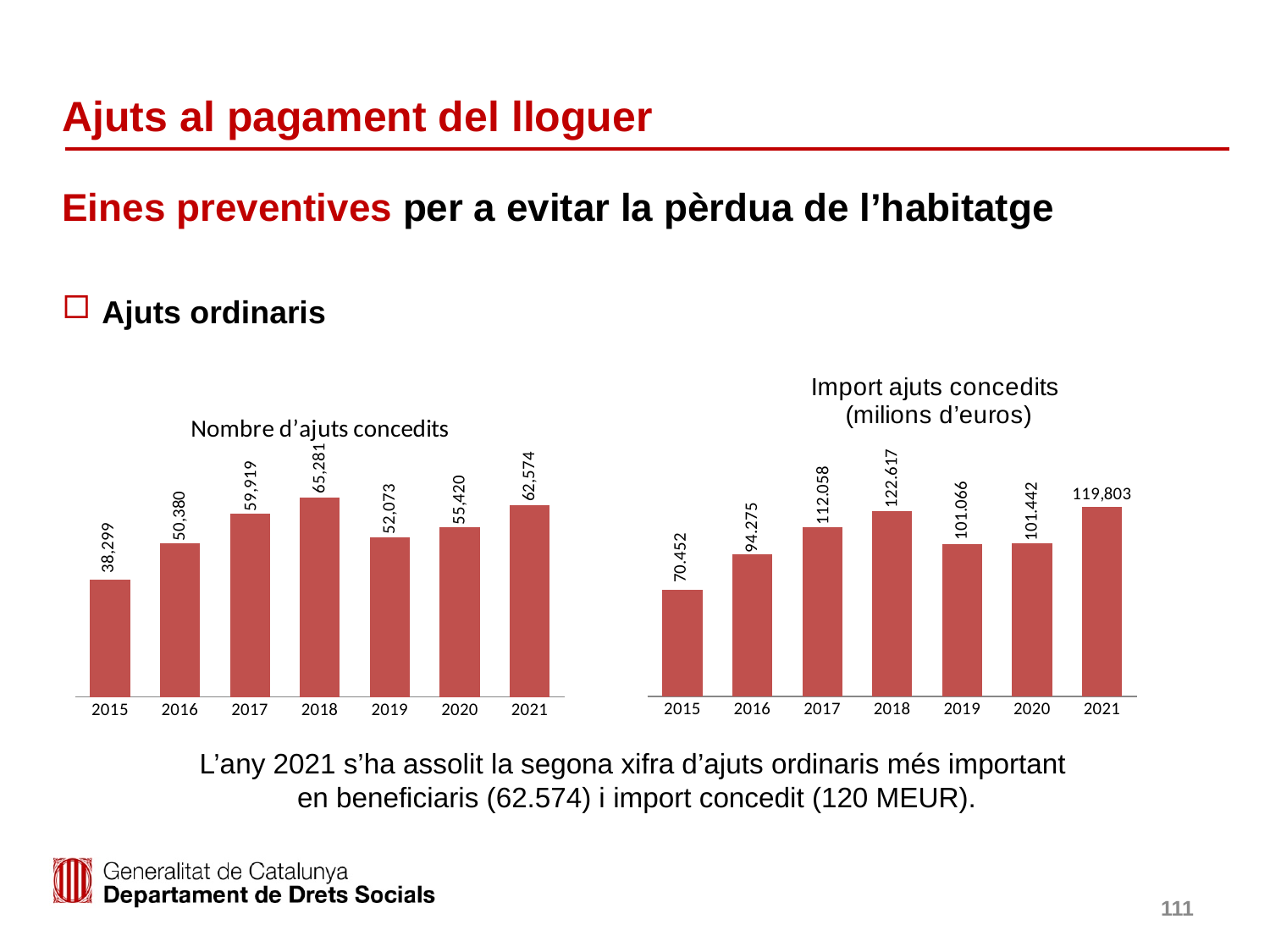
In the chart titled "Nombre d'ajuts concedits", which year has the lowest value? 2015 In the chart titled "Import ajuts concedits (milions d'euros)", which year has the lowest value? 2015 In the chart titled "Nombre d'ajuts concedits", what is the value for 2015? 38,299 What kind of chart is the chart titled "Import ajuts concedits (milions d'euros)"? Bar chart In the chart titled "Import ajuts concedits (milions d'euros)", what is the value for 2018? 122.617 How many years are shown on the x axis of the chart titled "Nombre d'ajuts concedits"? 7 In the chart titled "Import ajuts concedits (milions d'euros)", which is larger, the value for 2017 or the value for 2021? 2021 In the chart titled "Nombre d'ajuts concedits", which year has the highest value? 2018 In the chart titled "Import ajuts concedits (milions d'euros)", what is the value for 2016? 94.275 In the chart titled "Nombre d'ajuts concedits", what is the difference between the values for 2018 and 2015? 26,982 In the chart titled "Nombre d'ajuts concedits", which is larger, the value for 2019 or the value for 2020? 2020 In the chart titled "Nombre d'ajuts concedits", what is the value for 2021? 62,574